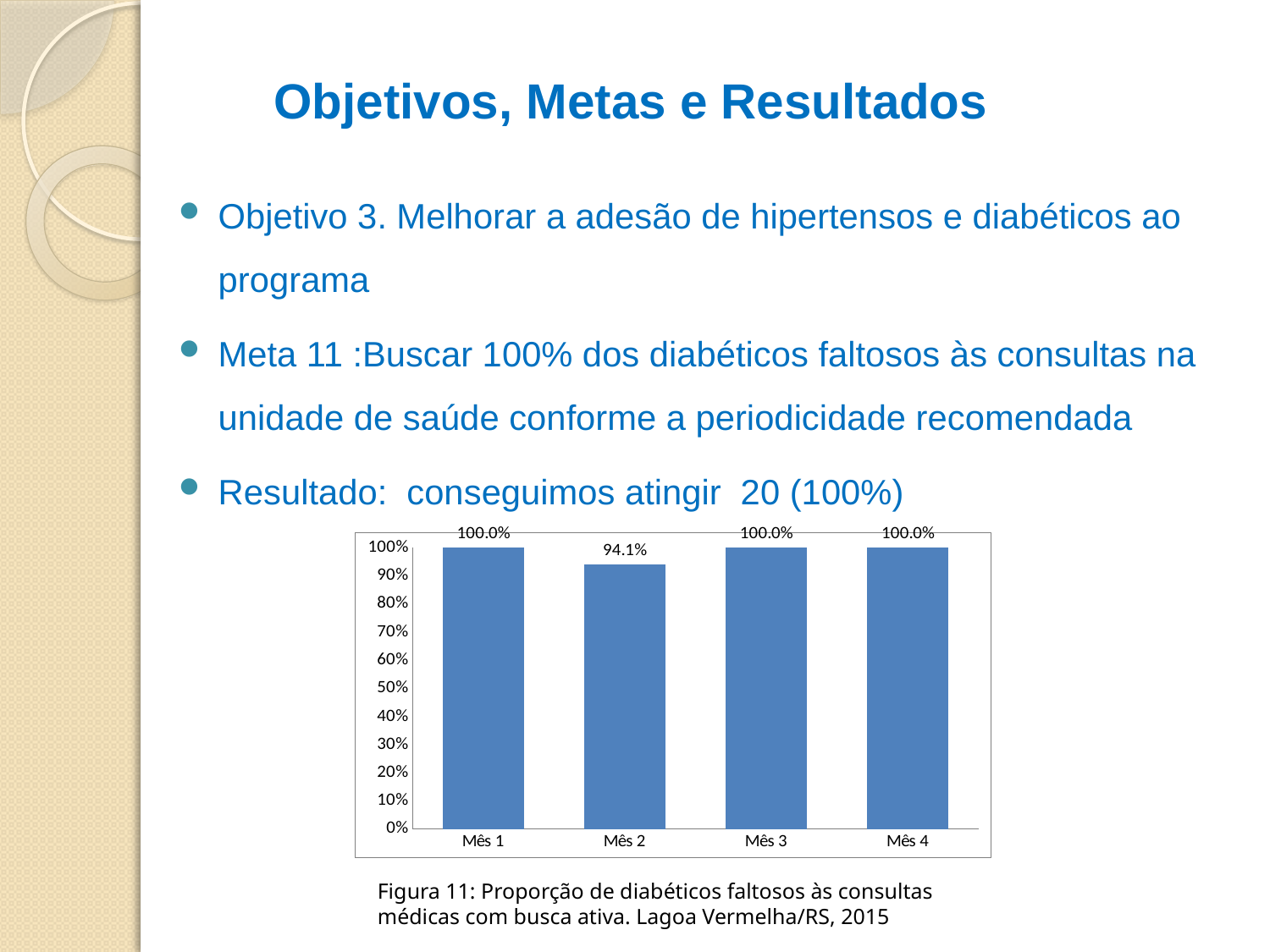
Is the value for Mês 2 greater or less than 90%? greater What is the difference between the values for Mês 1 and Mês 2? 5.9% Which is larger, the value for Mês 2 or the value for Mês 3? Mês 3 What is the value for Mês 1? 100.0% What is the figure number given in the caption below the chart? Figura 11 How many months have a value of 100.0%? 3 What kind of chart is shown on the slide? bar chart What is the value for Mês 2? 94.1% What is the value for Mês 4? 100.0% How many months are shown on the x axis? 4 Which month has the lowest value? Mês 2 What is the highest value shown on the y axis? 100%